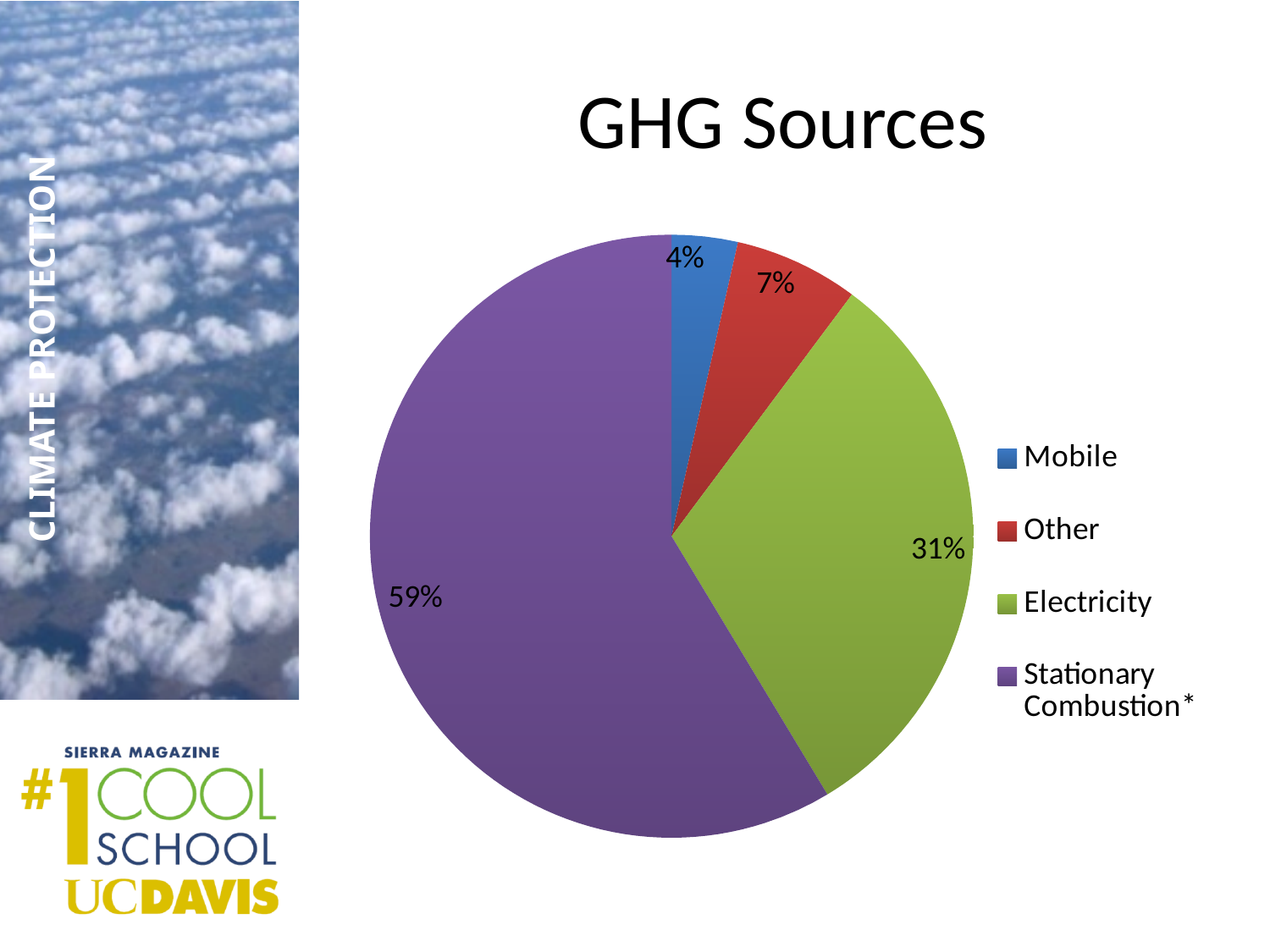
Which is larger, the share for Other or the share for Mobile? Other What colour is the Electricity slice? green What share of the pie does Electricity account for? 31% How many categories are shown in the pie chart? 4 What is the difference in percentage points between Stationary Combustion* and Electricity? 28 What share of the pie does Other account for? 7% Which category has the largest slice of the pie? Stationary Combustion* What share of the pie does Mobile account for? 4% What is the title of the chart? GHG Sources Which category has the smallest slice of the pie? Mobile What type of chart is shown on the slide? pie chart